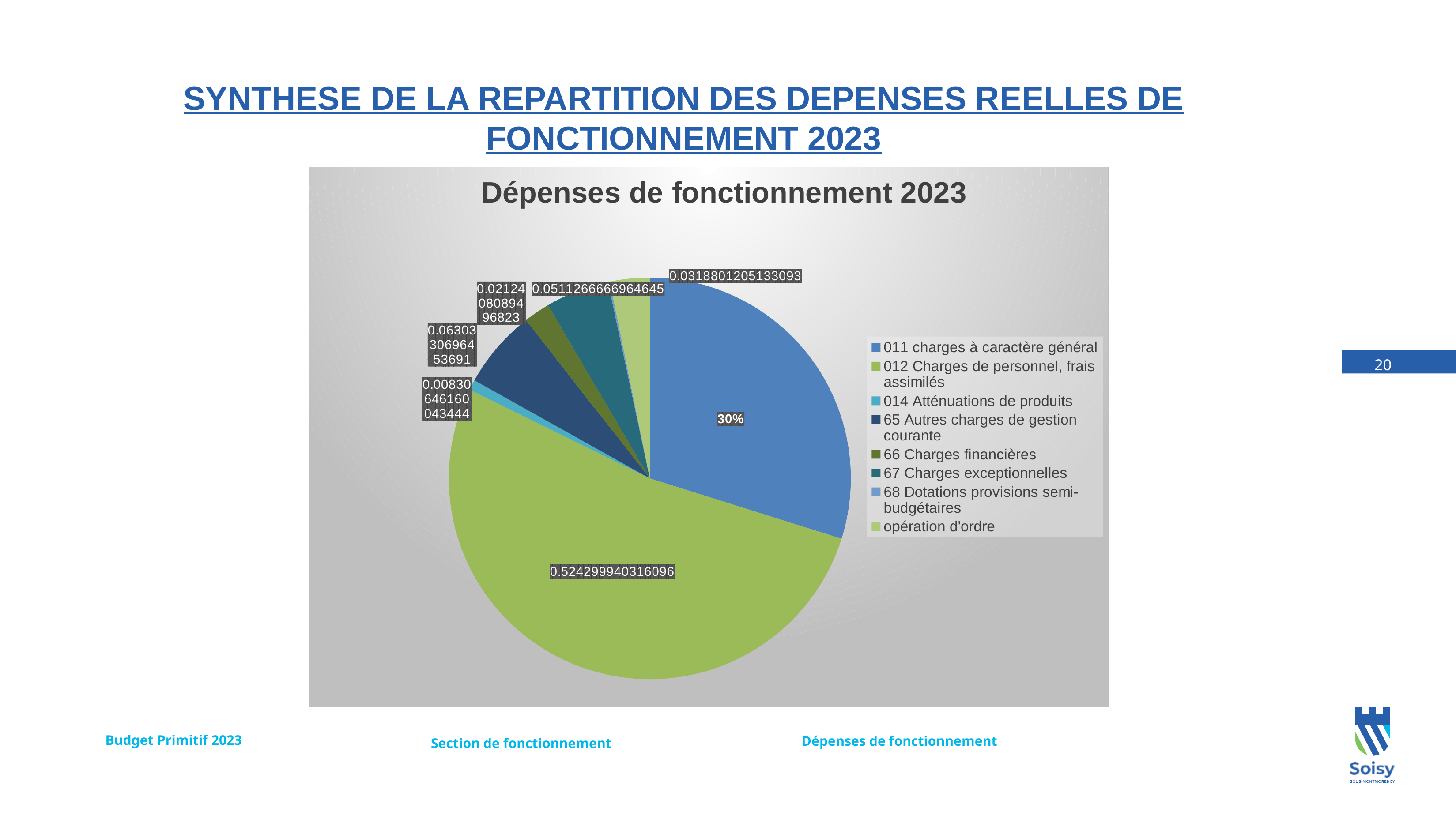
What is the value shown for 011 charges à caractère général? 30% What is the value shown for 65 Autres charges de gestion courante? 0.0630330696453691 What is the value shown for 012 Charges de personnel, frais assimilés? 0.524299940316096 Which is larger: 65 Autres charges de gestion courante or 67 Charges exceptionnelles? 65 Autres charges de gestion courante What kind of chart is shown on the slide? pie chart What is the value shown for opération d'ordre? 0.0318801205133093 What is the value shown for 67 Charges exceptionnelles? 0.0511266666964645 Which is larger: 011 charges à caractère général or 012 Charges de personnel, frais assimilés? 012 Charges de personnel, frais assimilés What is the value shown for 66 Charges financières? 0.0212408089496823 How many categories does the legend of the pie chart list? 8 What is the title of the chart? Dépenses de fonctionnement 2023 Which category has the largest slice of the pie? 012 Charges de personnel, frais assimilés